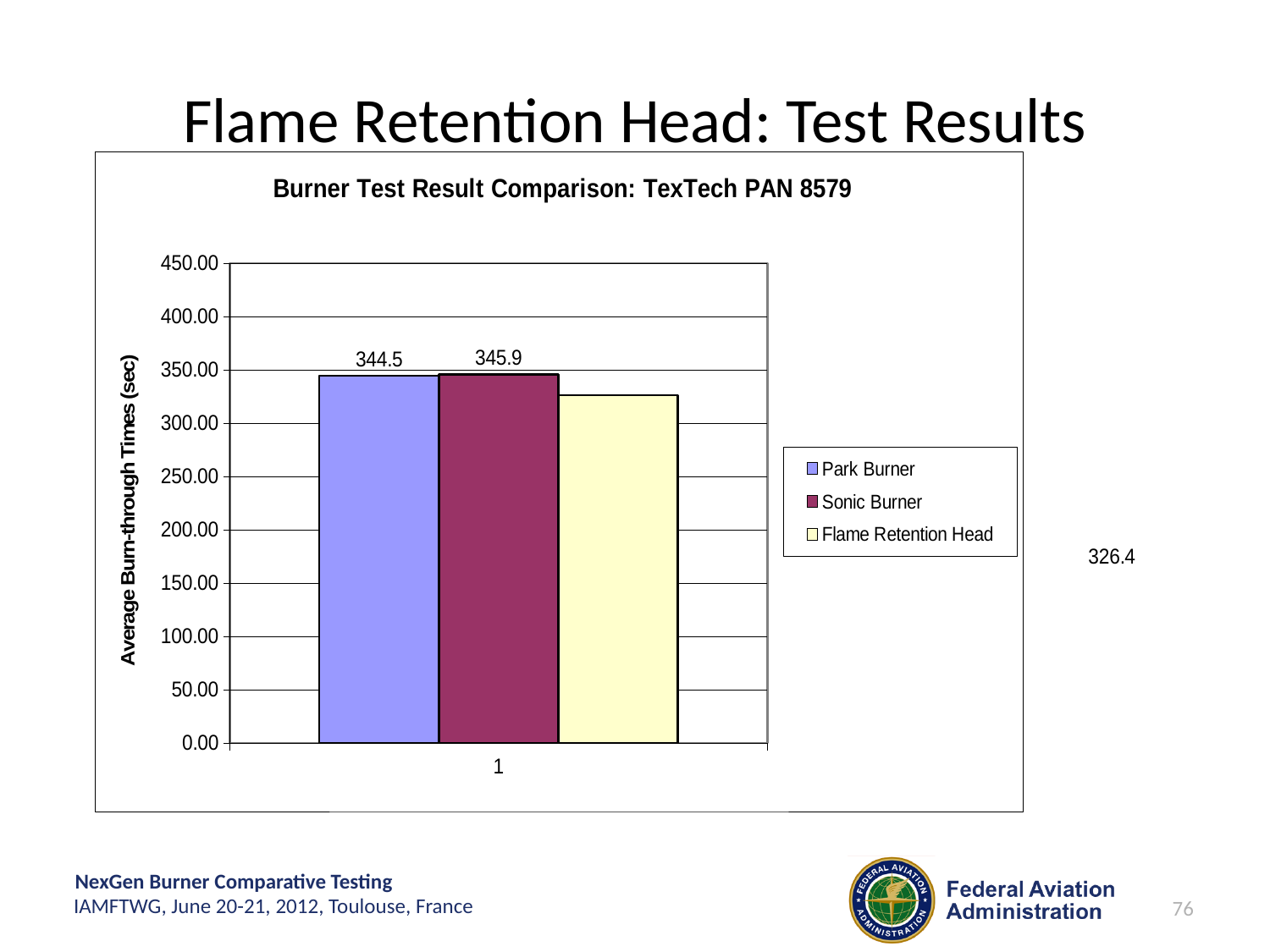
Which has a larger average burn-through time, the Park Burner or the Flame Retention Head? Park Burner What is the title of the chart? Burner Test Result Comparison: TexTech PAN 8579 What is the average burn-through time for the Flame Retention Head? 326.4 What is the difference between the Park Burner and Flame Retention Head average burn-through times? 18.1 What is the average burn-through time for the Sonic Burner? 345.9 Which burner has the highest average burn-through time? Sonic Burner What is the average burn-through time for the Park Burner? 344.5 What is the difference between the Sonic Burner and Park Burner average burn-through times? 1.4 Is the value for the Flame Retention Head greater or less than 300.00? greater How many series does the legend list? 3 Which burner has the lowest average burn-through time? Flame Retention Head What kind of chart is shown on the slide? Bar chart